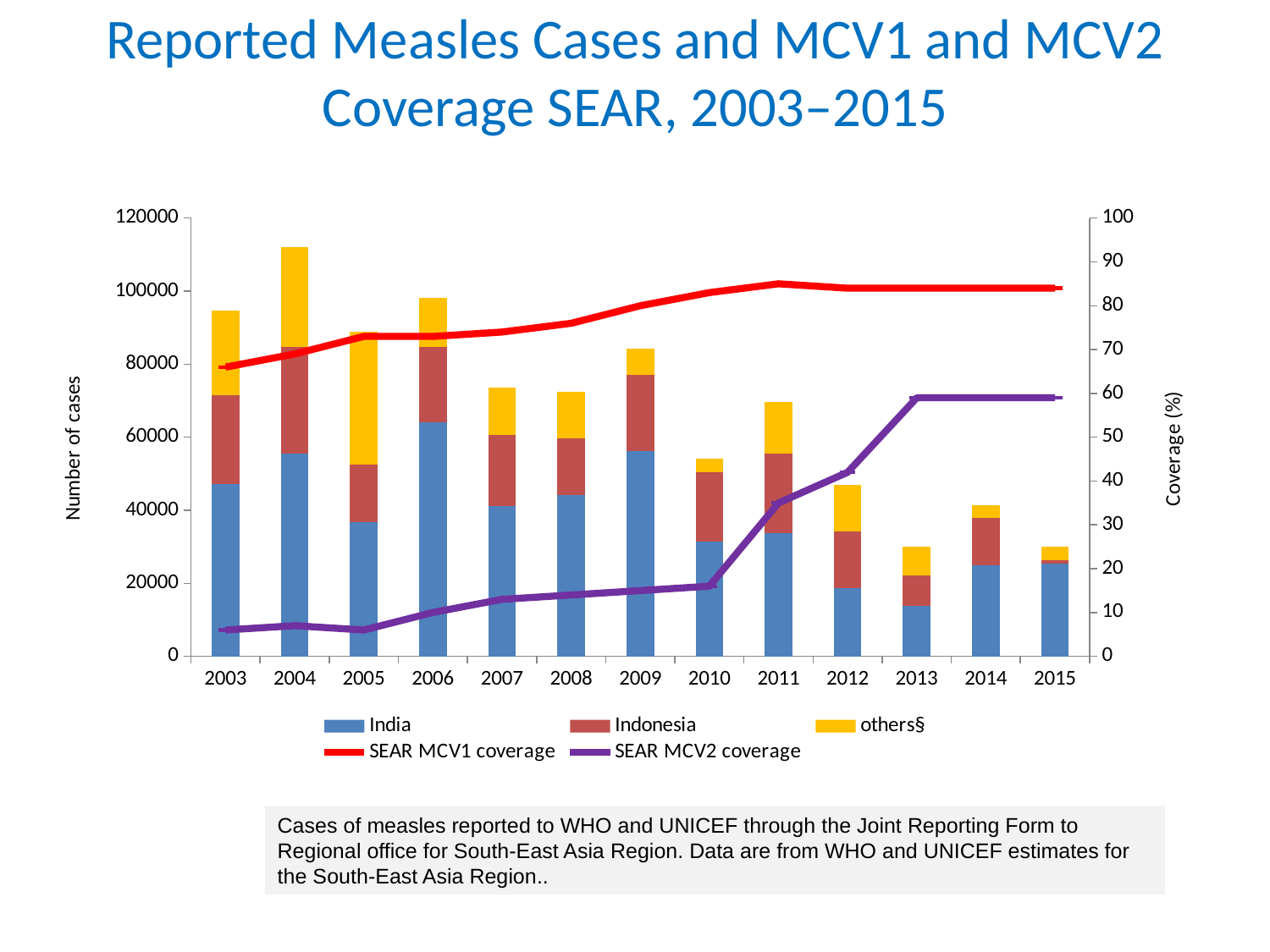
How many years are shown along the x axis? 13 Which year has the highest total number of reported measles cases? 2004 Is the SEAR MCV2 coverage in 2015 greater or less than 50%? greater How many series does the legend list? 5 Which year has more reported cases for India, 2004 or 2005? 2004 Is the SEAR MCV1 coverage in 2003 greater or less than 70%? less Is the number of cases for India in 2003 greater or less than 40000? greater Does the SEAR MCV1 coverage line generally rise or fall from 2003 to 2015? rise In which year is the India segment of the bar the tallest? 2006 In which year is the India segment of the bar the shortest? 2013 What kind of chart is shown on the slide? A stacked bar chart combined with line series